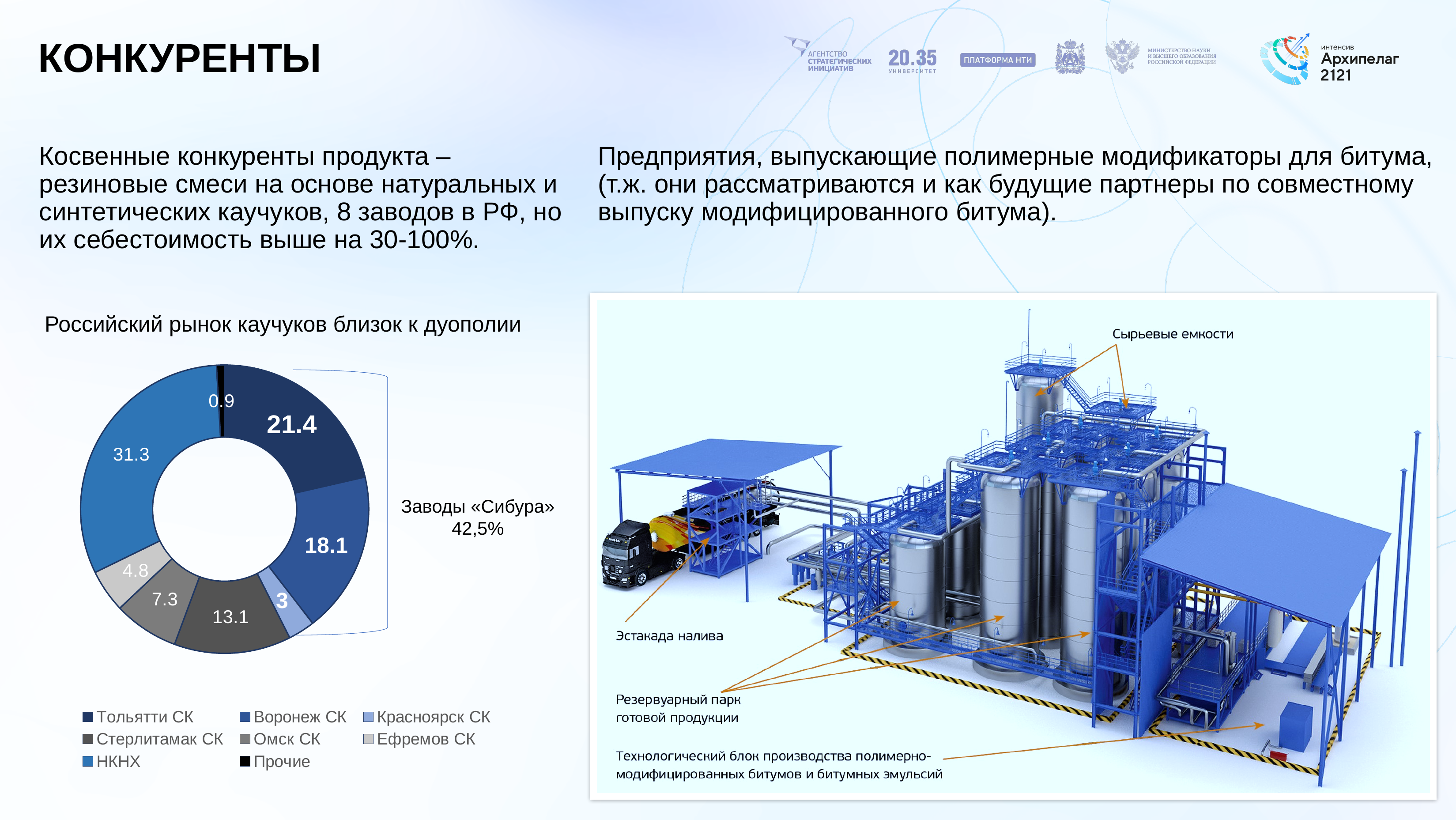
What combined share is labelled for Заводы «Сибура» on the chart? 42,5% Which category has the smallest share in the chart? Прочие What is the difference between the values for НКНХ and Тольятти СК? 9.9 What kind of chart is shown on the slide? Donut (pie) chart Which is larger, the value for Омск СК or the value for Ефремов СК? Омск СК What is the title of the chart on the slide? Российский рынок каучуков близок к дуополии What is the value shown for НКНХ in the chart? 31.3 How many categories does the chart legend list? 8 What is the value shown for Красноярск СК in the chart? 3 What is the value shown for Стерлитамак СК in the chart? 13.1 Which category has the largest share in the chart? НКНХ What is the value shown for Тольятти СК in the chart? 21.4